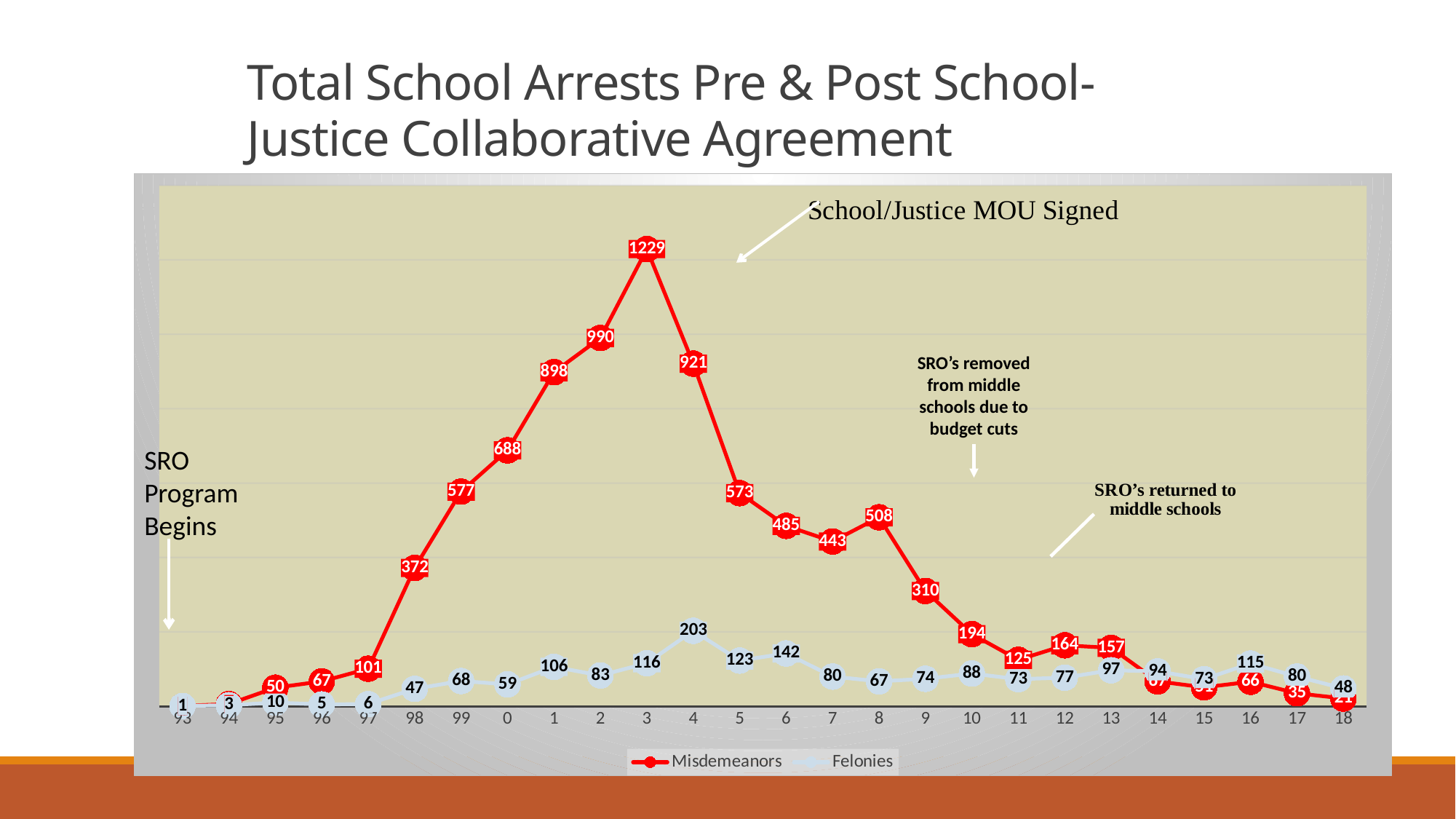
What type of chart is shown on the slide? line chart In which year does the Misdemeanors series reach its highest value? 3 How many series does the legend list? 2 Which is larger in year 17, the Misdemeanors value or the Felonies value? Felonies What is the Felonies value for year 16? 115 What is the title of the chart? Total School Arrests Pre & Post School-Justice Collaborative Agreement What is the difference between the Misdemeanors values for year 3 and year 4? 308 What is the Misdemeanors value for year 98? 372 In which year does the Felonies series reach its highest value? 4 What is the Misdemeanors value for year 3? 1229 What is the Felonies value for year 4? 203 Does the Misdemeanors series rise or fall between year 3 and year 10? fall